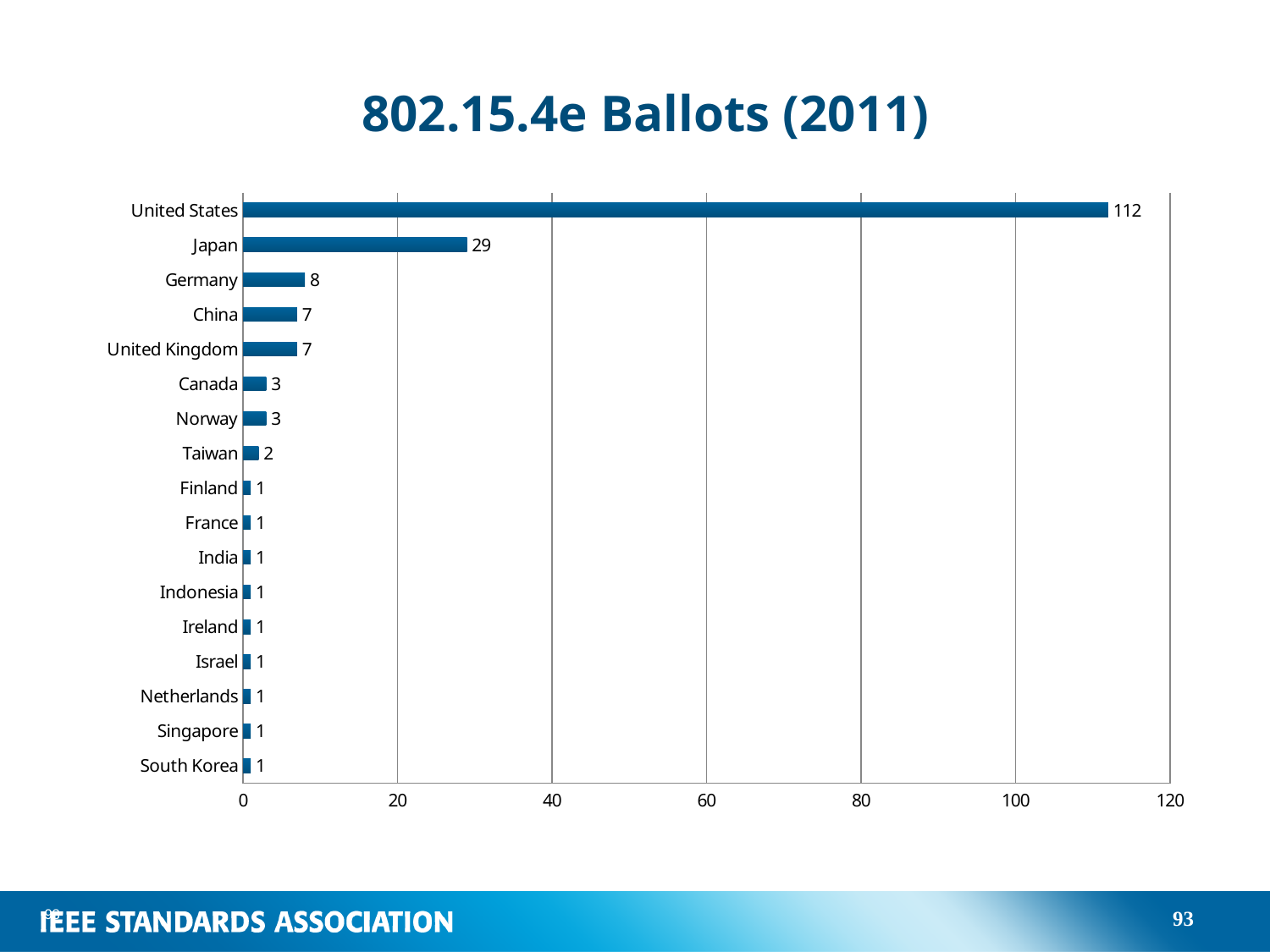
What is the difference between the values for the United States and Japan? 83 What is the difference between the values for Germany and China? 1 What is the title of the chart? 802.15.4e Ballots (2011) How many countries are shown in the chart? 17 Is the value for the United States greater or less than 100? greater Which country has the highest value? United States What kind of chart is shown on the slide? bar chart What is the value for Japan? 29 Which is larger, the value for Japan or the value for Germany? Japan What is the value for Germany? 8 What is the value for the United States? 112 What is the value for Taiwan? 2